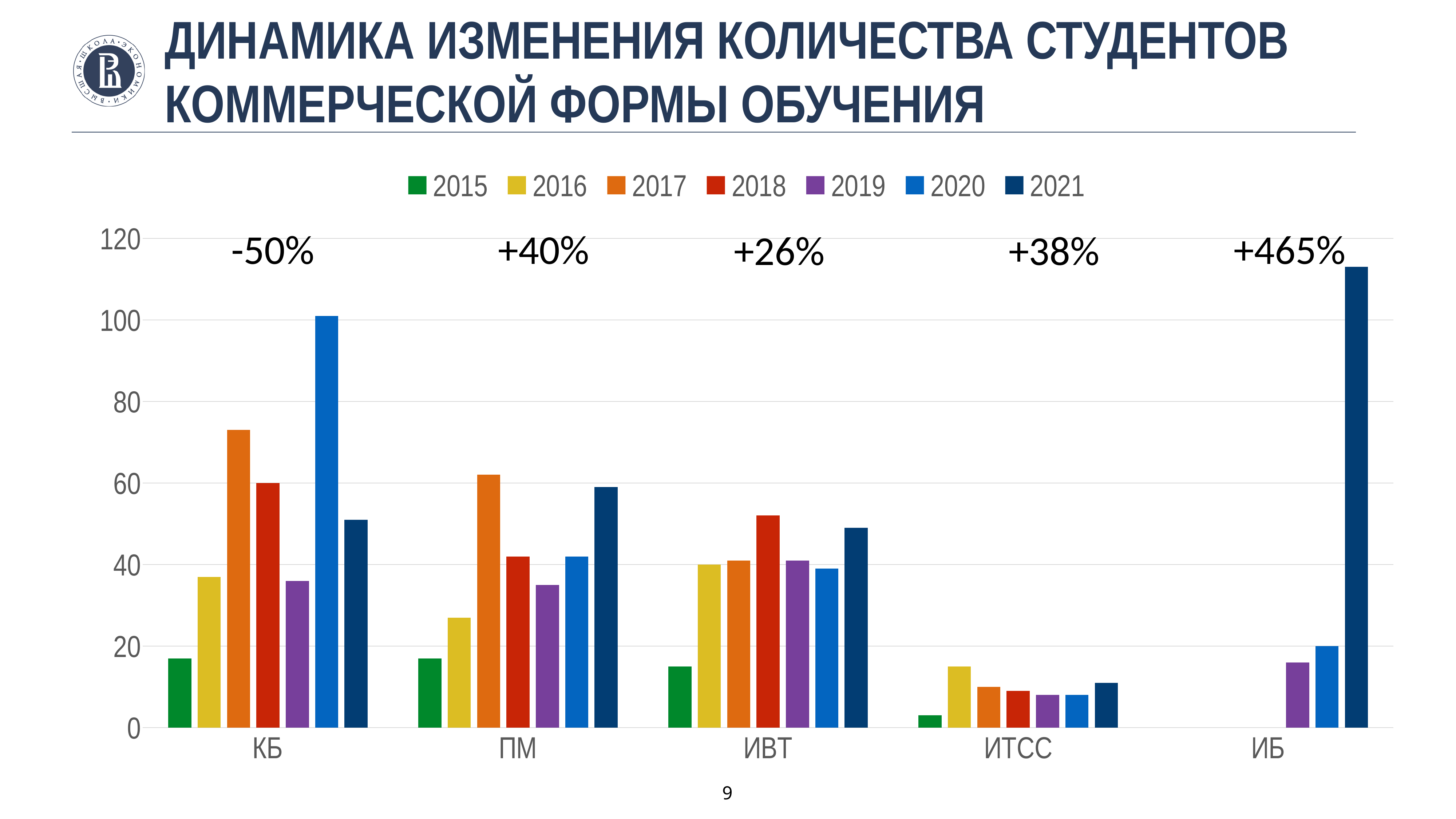
Which is larger in the КБ group: the 2020 bar or the 2021 bar? 2020 Is the value for 2015 in the ИТСС group greater or less than 20? less Which year has the lowest bar in the ИТСС group? 2015 How many categories are shown on the x axis? 5 How many series does the legend list? 7 Which is larger for 2021: the ПМ bar or the ИВТ bar? ПМ Which category contains the tallest bar on the chart? ИБ Is the value for 2021 in the ИБ group greater or less than 100? greater What percentage change is printed above the ИБ group? +465% Is the value for 2018 in the ИВТ group greater or less than 40? greater What kind of chart is shown on the slide? bar chart Which year has the tallest bar in the КБ group? 2020